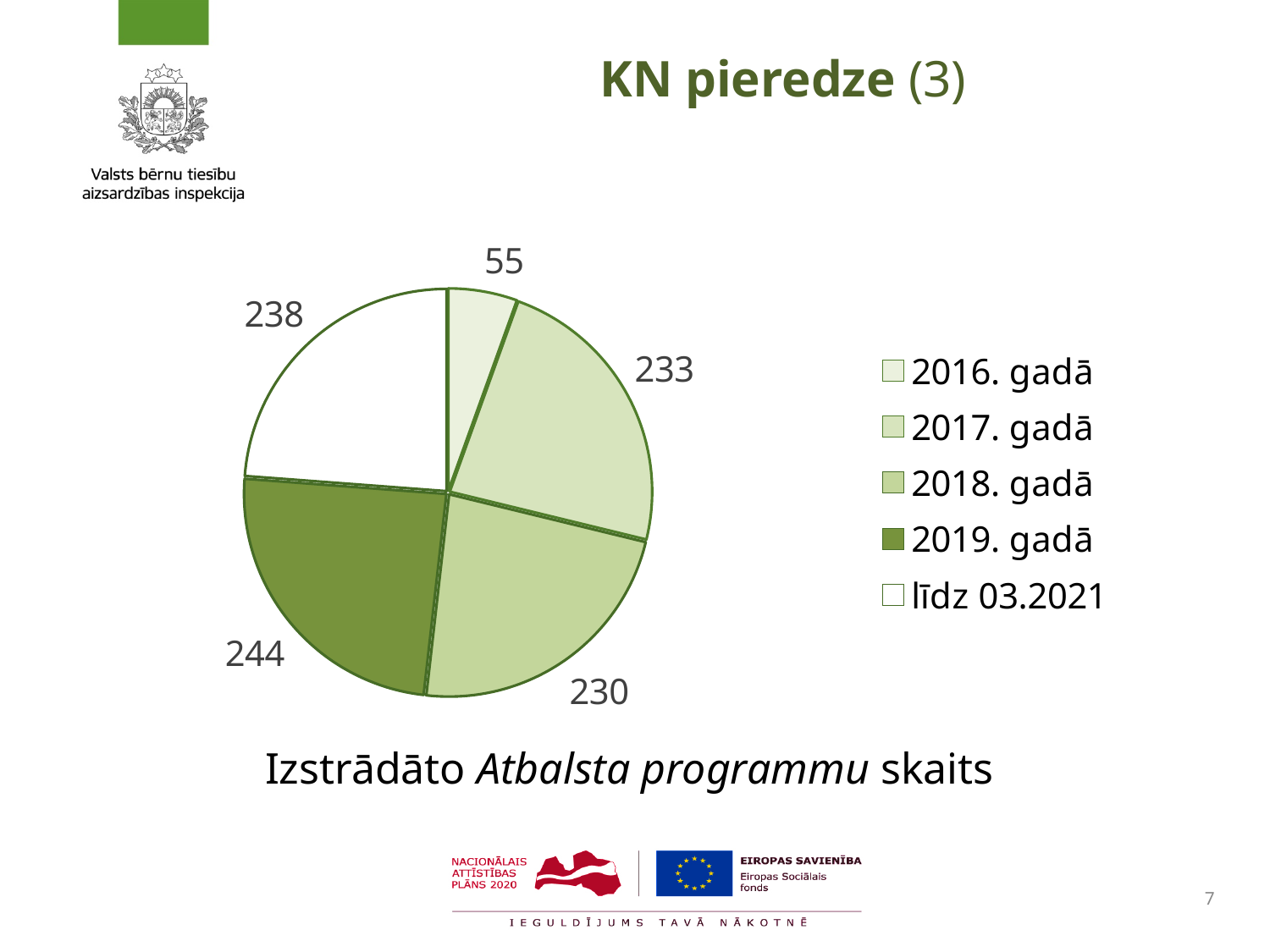
Which is larger, the value for 2017. gadā or the value for 2018. gadā? 2017. gadā What is the caption shown below the pie chart? Izstrādāto Atbalsta programmu skaits What is the value for 2019. gadā? 244 How many categories does the legend list? 5 What is the value for 2018. gadā? 230 Which category has the largest slice of the pie? 2019. gadā What share of the pie does the 2016. gadā slice represent? 5.5% What is the value for līdz 03.2021? 238 What kind of chart is shown on the slide? pie chart What is the difference between the values for 2019. gadā and 2018. gadā? 14 What is the value for 2016. gadā? 55 Which category has the smallest slice of the pie? 2016. gadā